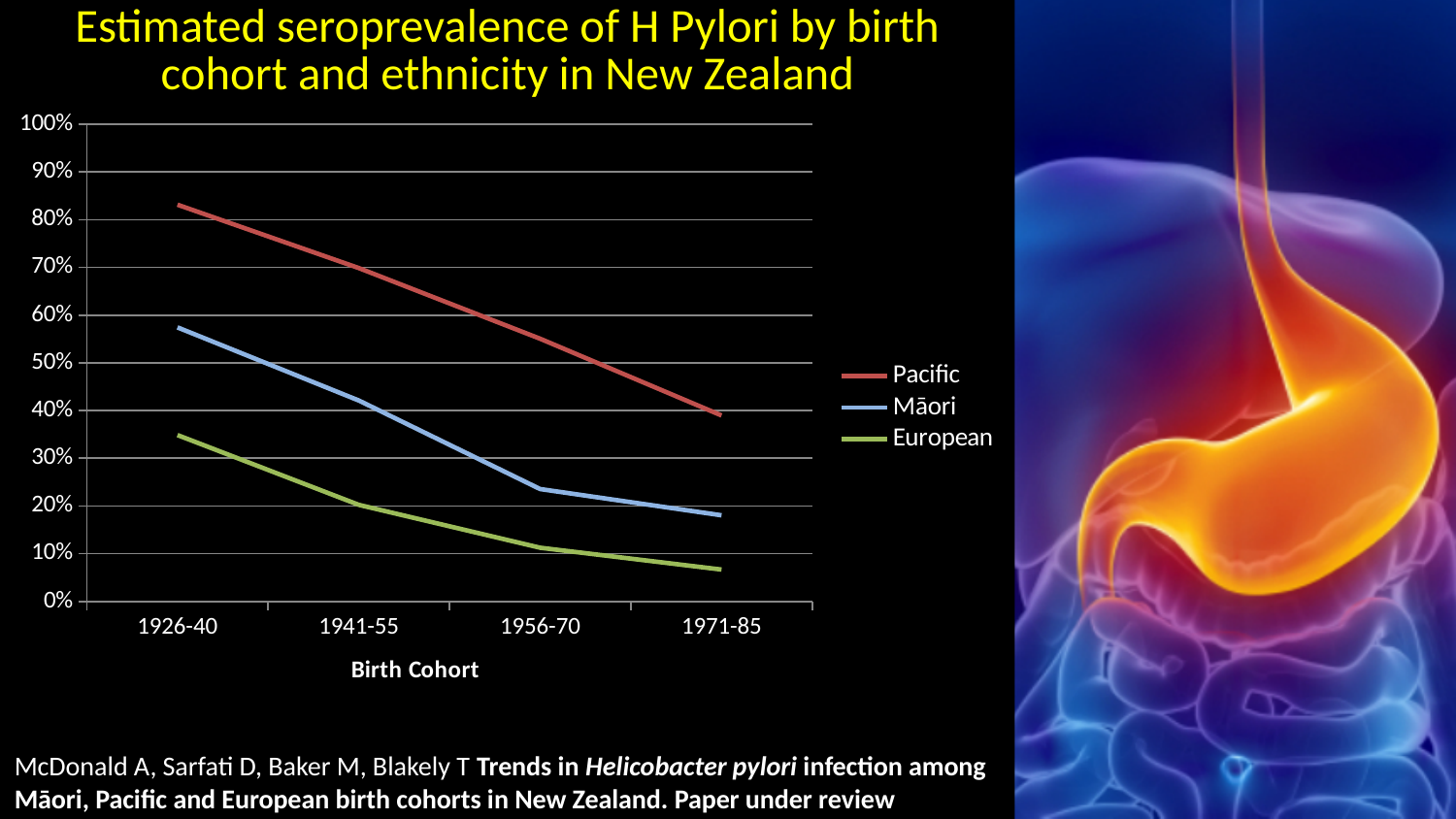
Is the seroprevalence for European in the 1971-85 cohort greater or less than 10%? less What kind of chart is shown on the slide? line chart Is the seroprevalence for Pacific in the 1971-85 cohort greater or less than 50%? less Which ethnicity has the lowest seroprevalence in the 1971-85 birth cohort? European How many birth cohorts are shown on the x axis? 4 Which ethnicity has the highest seroprevalence in the 1926-40 birth cohort? Pacific How many series does the legend list? 3 Is the seroprevalence for Māori in the 1926-40 cohort greater or less than 50%? greater Which is larger in the 1956-70 cohort, the seroprevalence for Māori or for European? Māori Does the seroprevalence for Māori rise or fall across the birth cohorts from 1926-40 to 1971-85? fall